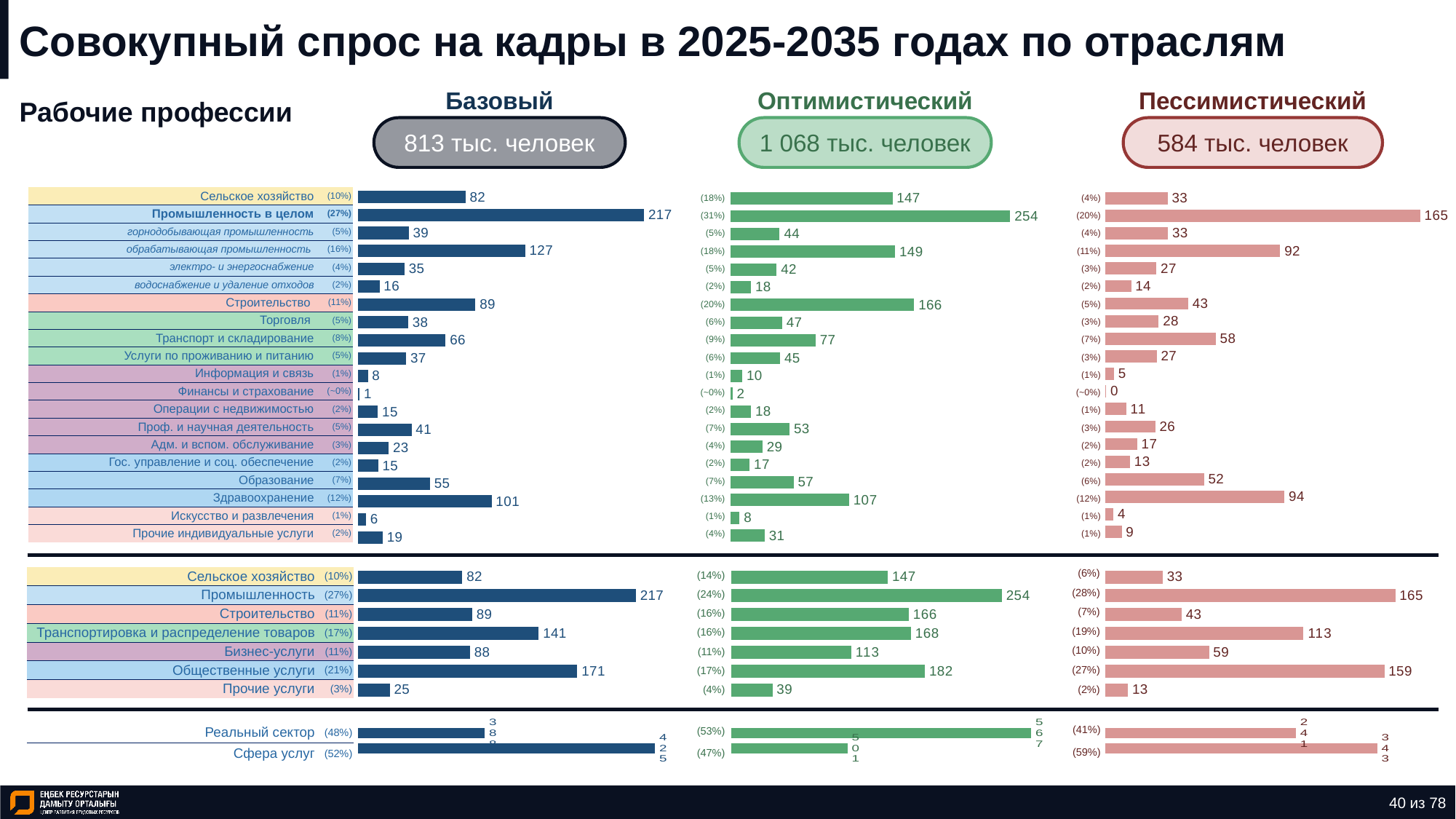
In the Базовый chart, what is the value for Транспорт и складирование? 66 What is the difference between the Оптимистический and Пессимистический values for Сельское хозяйство? 114 What type of chart is used to show the demand by industry on this slide? Bar chart In the Оптимистический chart, what is the value for Строительство? 166 In the Пессимистический chart, what is the value for Промышленность в целом? 165 What total is shown in the oval above the Оптимистический chart? 1 068 тыс. человек In the Пессимистический chart, which is larger: Образование or Здравоохранение? Здравоохранение In the Базовый chart, what is the value for Здравоохранение? 101 In the Базовый chart, which industry in the top block has the highest value? Промышленность в целом How many scenarios (charts) are shown side by side on the slide? 3 In the Оптимистический chart, which industry in the top block has the lowest value? Финансы и страхование In the Базовый chart, what is the difference between Строительство and Торговля? 51